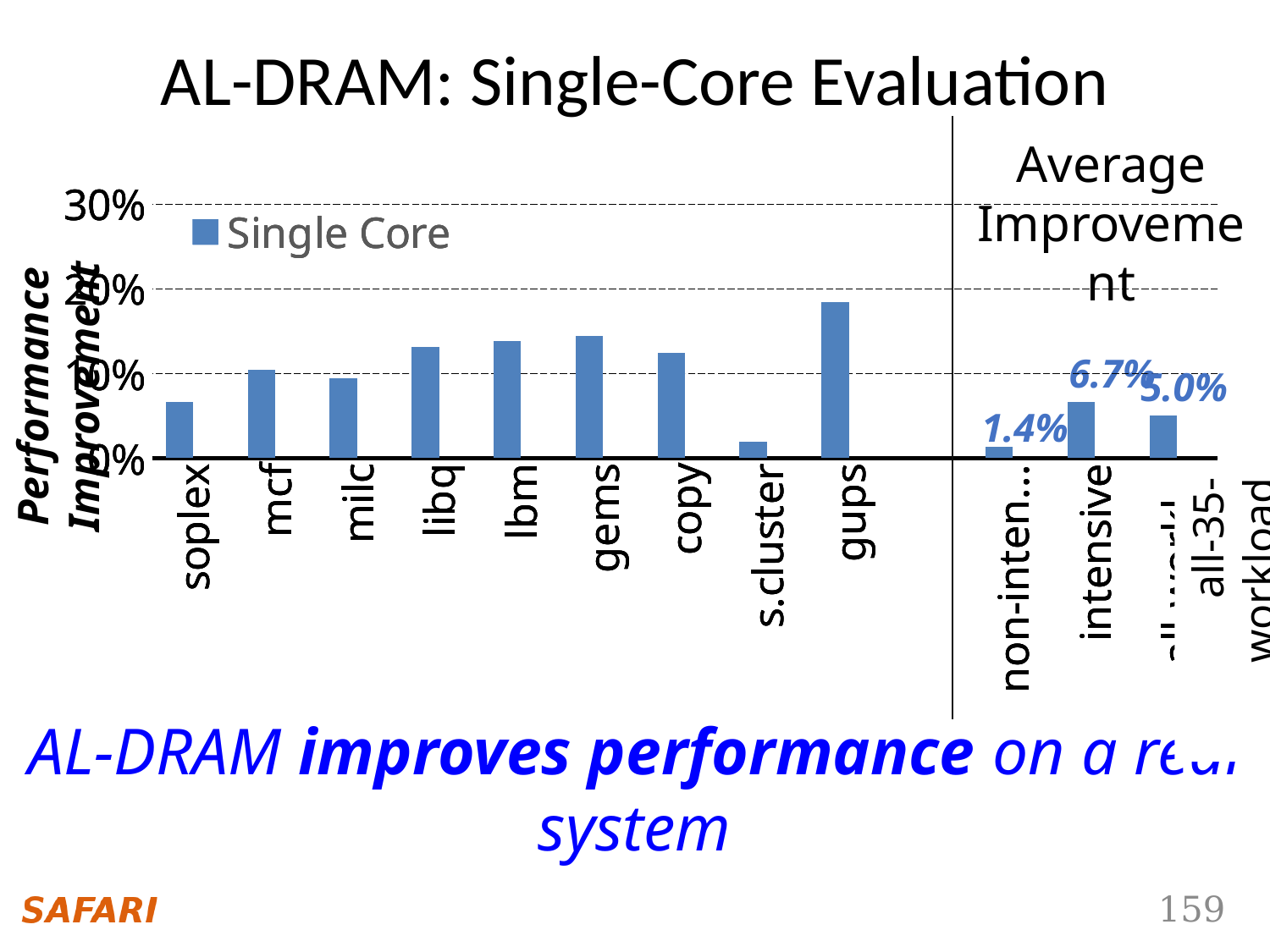
What is the average performance improvement shown for all 35 workloads? 5.0% Is the performance improvement for soplex greater or less than 10%? less How many categories are shown on the x axis of the chart? 12 What is the average performance improvement shown for the non-intensive workloads? 1.4% Among the nine individual workloads on the left of the chart, which has the lowest performance improvement? s.cluster Which has a larger performance improvement, gups or lbm? gups Which workload has the highest performance improvement in the chart? gups What is the difference between the average improvement for intensive workloads and for non-intensive workloads? 5.3% What is the average performance improvement shown for the intensive workloads? 6.7% What type of chart is shown on the slide? bar chart Is the performance improvement for gups greater or less than 10%? greater How many series does the legend list? 1